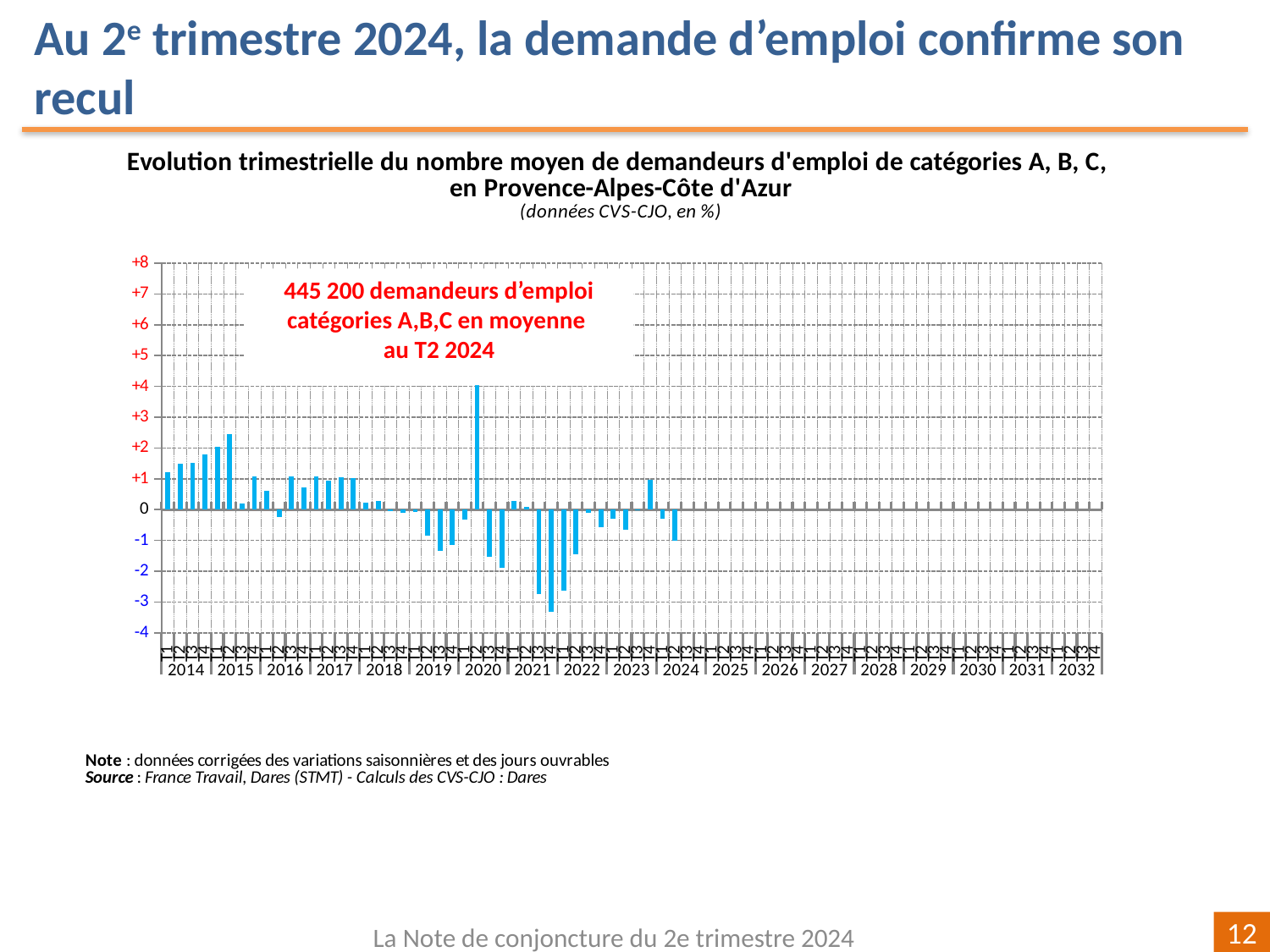
Do the values rise or fall from T1 2014 to T2 2015? rise Which quarter has the highest value in the chart? T2 2020 What is the highest value shown on the vertical axis of the chart? +8 Is the value for T2 2020 greater or less than +3? greater Is the value for T2 2021 greater or less than -3? greater Is the value for T2 2024 greater or less than 0? less According to the annotation on the chart, how many job seekers in categories A, B, C were there on average in T2 2024? 445 200 Which is larger, the value for T2 2020 or the value for T2 2015? T2 2020 Which quarter has the lowest value in the chart? T4 2021 What kind of chart is shown on the slide? bar chart